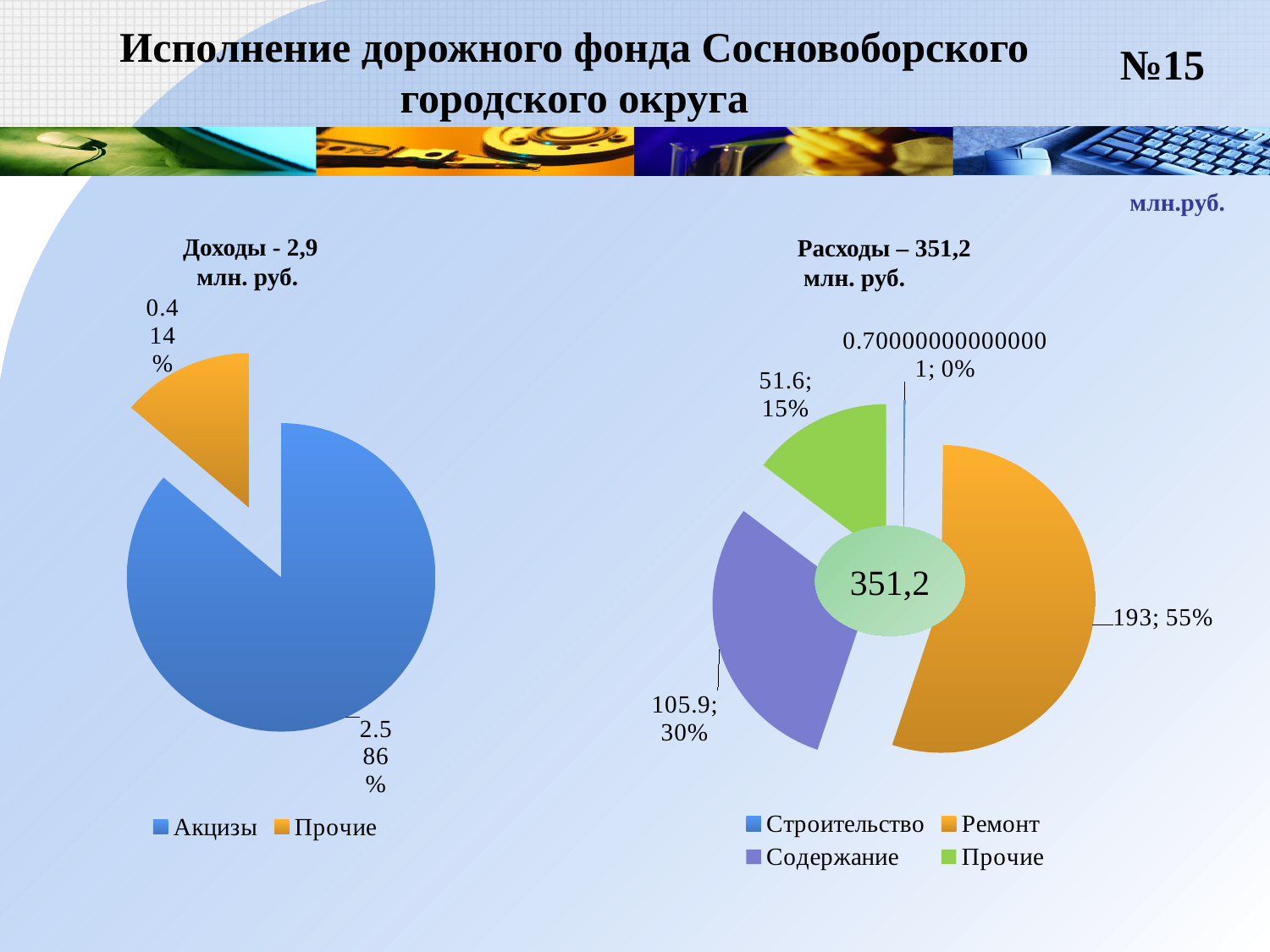
In the 'Расходы – 351,2 млн. руб.' chart, which is larger: Содержание or Прочие? Содержание In the 'Расходы – 351,2 млн. руб.' chart, what is the value for Содержание? 105.9 In the 'Расходы – 351,2 млн. руб.' chart, which category is the smallest? Строительство In the 'Расходы – 351,2 млн. руб.' chart, what share of the pie does Прочие take? 15% How many categories does the legend of the 'Расходы – 351,2 млн. руб.' chart list? 4 How many categories does the legend of the 'Доходы - 2,9 млн. руб.' chart list? 2 In the 'Доходы - 2,9 млн. руб.' chart, which category is the largest? Акцизы In the 'Доходы - 2,9 млн. руб.' chart, what share of the pie does Прочие take? 14% In the 'Доходы - 2,9 млн. руб.' chart, what is the value for Акцизы? 2.5 What type of chart is used for the 'Доходы - 2,9 млн. руб.' chart? pie chart In the 'Расходы – 351,2 млн. руб.' chart, what is the difference between the values for Ремонт and Содержание? 87.1 In the 'Расходы – 351,2 млн. руб.' chart, what is the value for Ремонт? 193